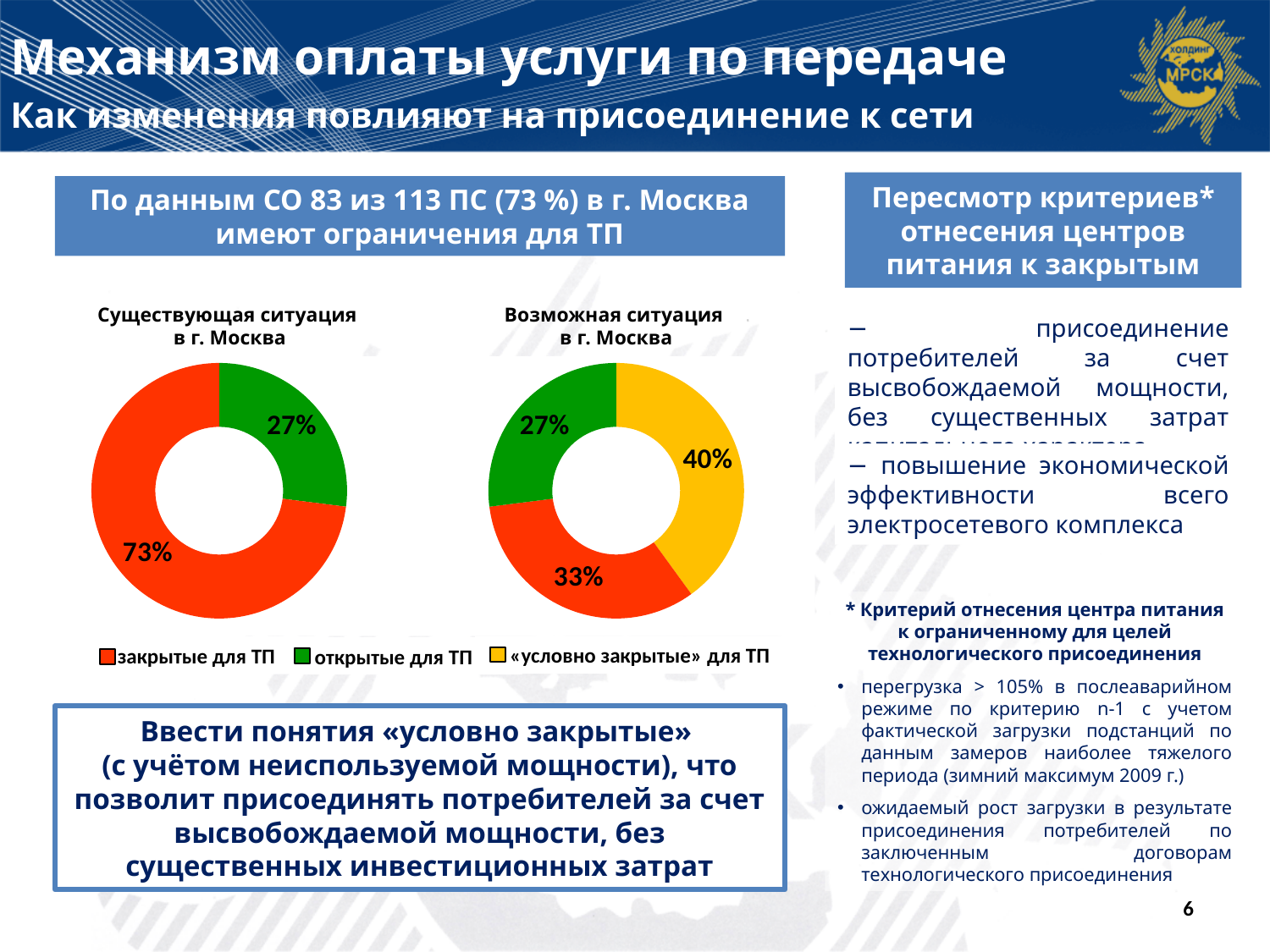
In the chart 'Возможная ситуация в г. Москва', which category has the largest share? «условно закрытые» для ТП In the chart 'Существующая ситуация в г. Москва', which is larger: 'закрытые для ТП' or 'открытые для ТП'? закрытые для ТП In the chart 'Возможная ситуация в г. Москва', what share is labelled for 'открытые для ТП'? 27% In the chart 'Существующая ситуация в г. Москва', what share is labelled for 'открытые для ТП'? 27% What type of chart is 'Существующая ситуация в г. Москва'? Doughnut chart How many slices does the chart 'Возможная ситуация в г. Москва' have? 3 In the chart 'Существующая ситуация в г. Москва', what is the difference between the shares of 'закрытые для ТП' and 'открытые для ТП'? 46% In the chart 'Возможная ситуация в г. Москва', what share is labelled for '«условно закрытые» для ТП'? 40% In the chart 'Возможная ситуация в г. Москва', what share is labelled for 'закрытые для ТП'? 33% In the chart 'Существующая ситуация в г. Москва', what share is labelled for 'закрытые для ТП'? 73% In the chart 'Возможная ситуация в г. Москва', which category has the smallest share? открытые для ТП In the chart 'Возможная ситуация в г. Москва', what is the difference between the shares of '«условно закрытые» для ТП' and 'закрытые для ТП'? 7%